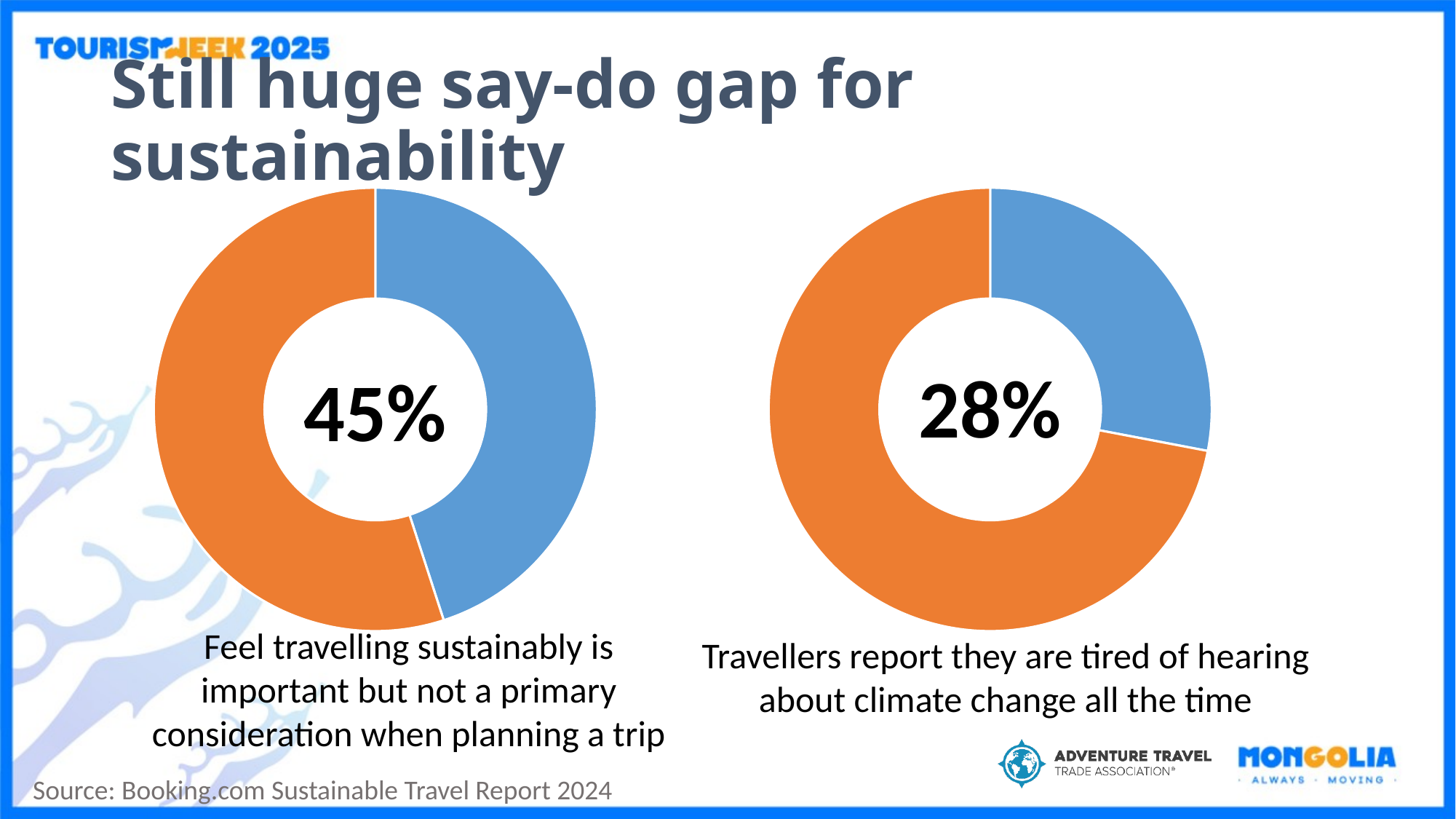
How many slices does the left donut chart have? 2 In the left chart, which colour slice is larger, the blue or the orange? Orange In the left chart, what percentage of travellers feel travelling sustainably is important but not a primary consideration when planning a trip? 45% In the right chart, which colour slice is larger, the blue or the orange? Orange What is the difference between the percentage in the left chart and the percentage in the right chart? 17% What kind of chart is shown on the left side of the slide? Donut chart What kind of chart is shown on the right side of the slide? Donut chart What source is cited for the data in the two donut charts? Booking.com Sustainable Travel Report 2024 What is the title of the slide containing the two donut charts? Still huge say-do gap for sustainability How many slices does the right donut chart have? 2 In the right chart, what percentage of travellers report they are tired of hearing about climate change all the time? 28% Which chart shows the larger highlighted percentage, the left chart (45%) or the right chart (28%)? The left chart